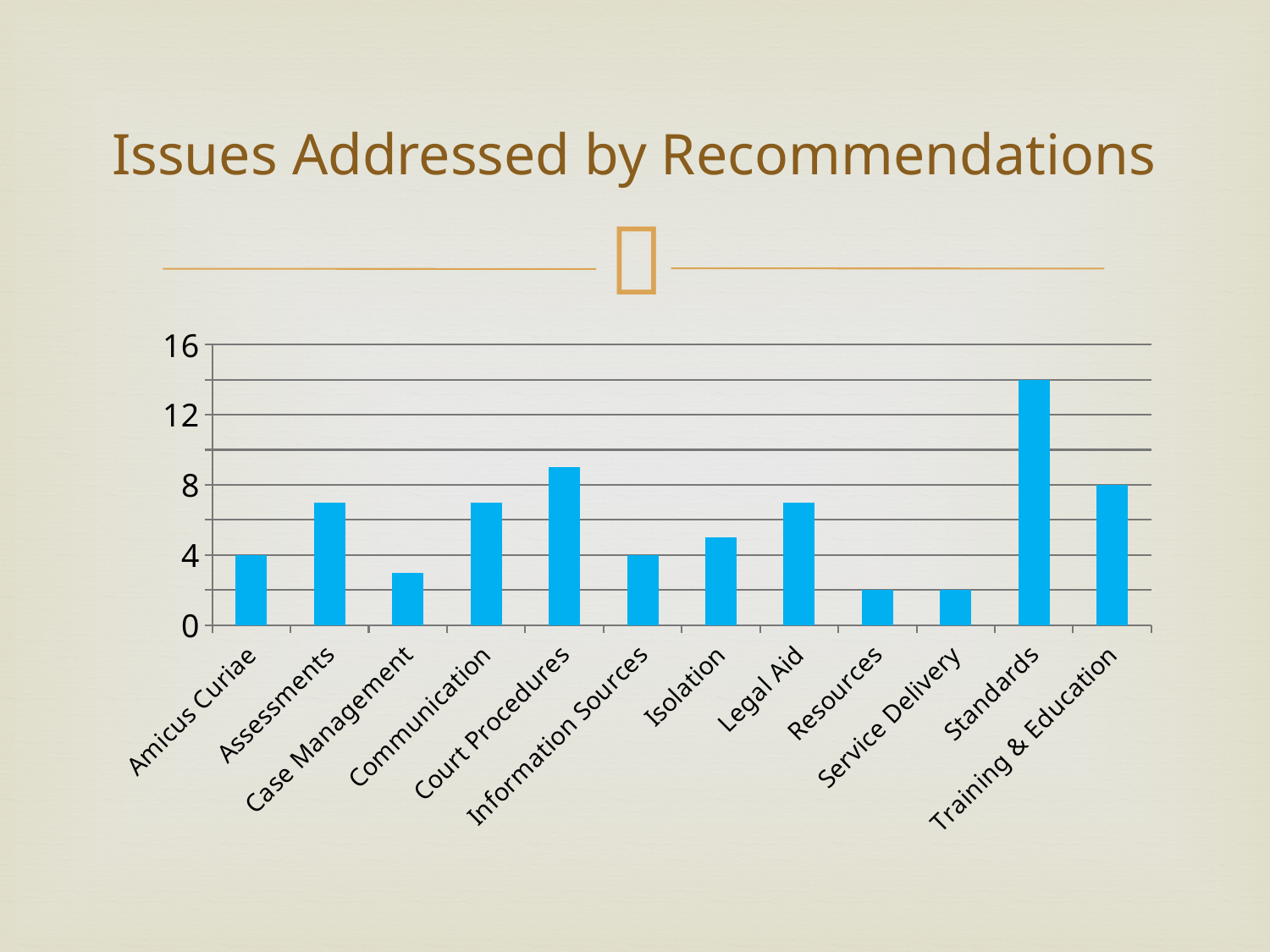
Which is larger, the value for Court Procedures or the value for Case Management? Court Procedures What type of chart is shown on the slide? bar chart Is the value for Resources greater or less than 4? less How many categories are shown on the x axis of the chart? 12 Which is larger, the value for Standards or the value for Legal Aid? Standards What is the value for Information Sources? 4 What is the value for Amicus Curiae? 4 Is the value for Court Procedures greater or less than 8? greater What is the value for Training & Education? 8 Is the value for Standards greater or less than 12? greater What is the title of the chart? Issues Addressed by Recommendations Which category has the highest value? Standards